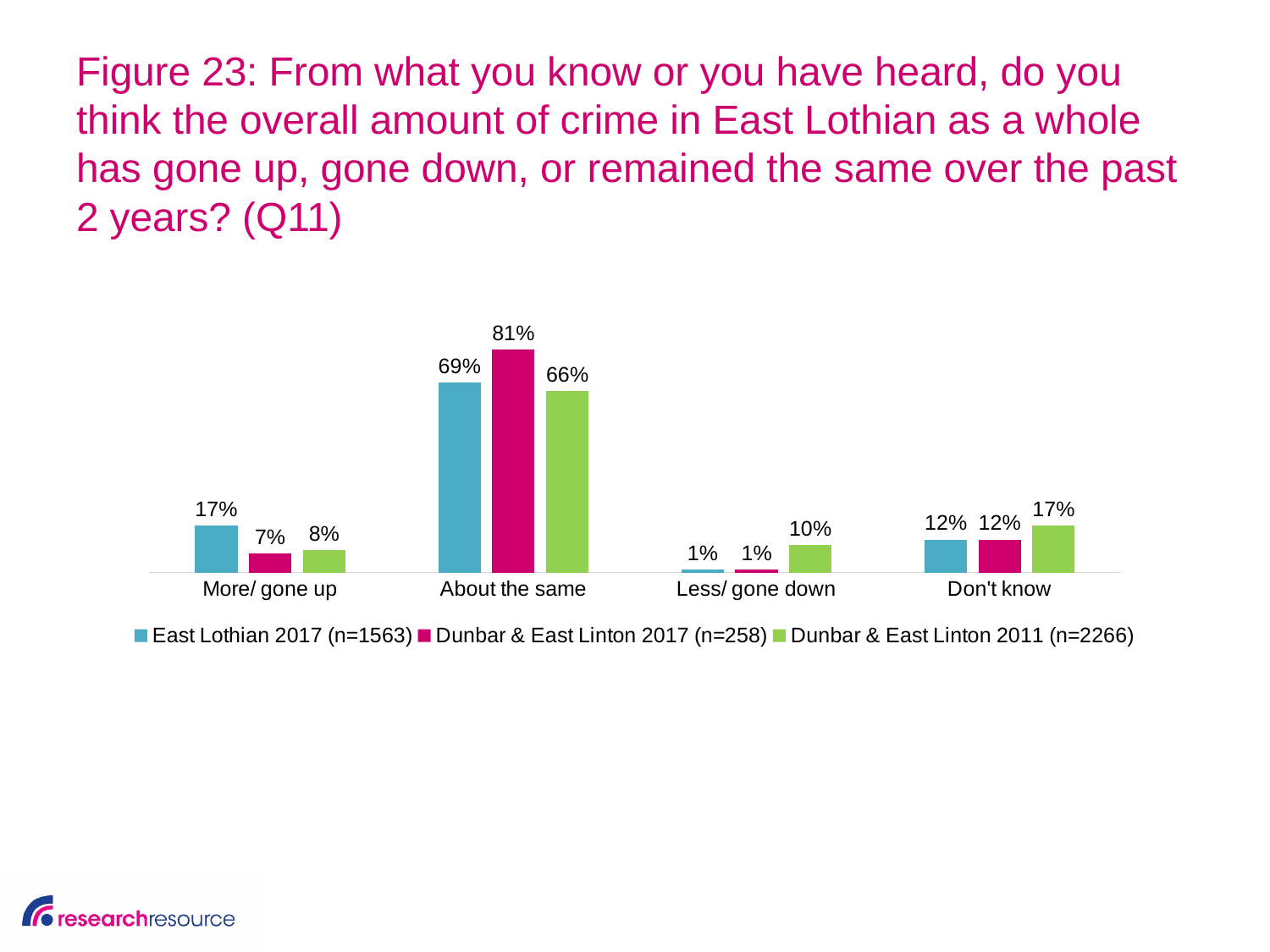
Which category has the lowest value for Dunbar & East Linton 2017? Less/ gone down What is the value for Dunbar & East Linton 2017 in the 'About the same' category? 81% What is the difference between the Dunbar & East Linton 2017 and Dunbar & East Linton 2011 values for 'About the same'? 15% Which category has the highest value for East Lothian 2017? About the same What is the value for Dunbar & East Linton 2011 in the 'Don't know' category? 17% How many series does the legend list? 3 How many categories are shown on the x axis? 4 What percentage of East Lothian 2017 respondents said crime has gone up (More/ gone up)? 17% What is the sample size (n) shown in the legend for Dunbar & East Linton 2017? 258 Which is larger for 'More/ gone up': East Lothian 2017 or Dunbar & East Linton 2011? East Lothian 2017 What kind of chart is shown on the slide? Bar chart What is the value for Dunbar & East Linton 2011 in the 'Less/ gone down' category? 10%